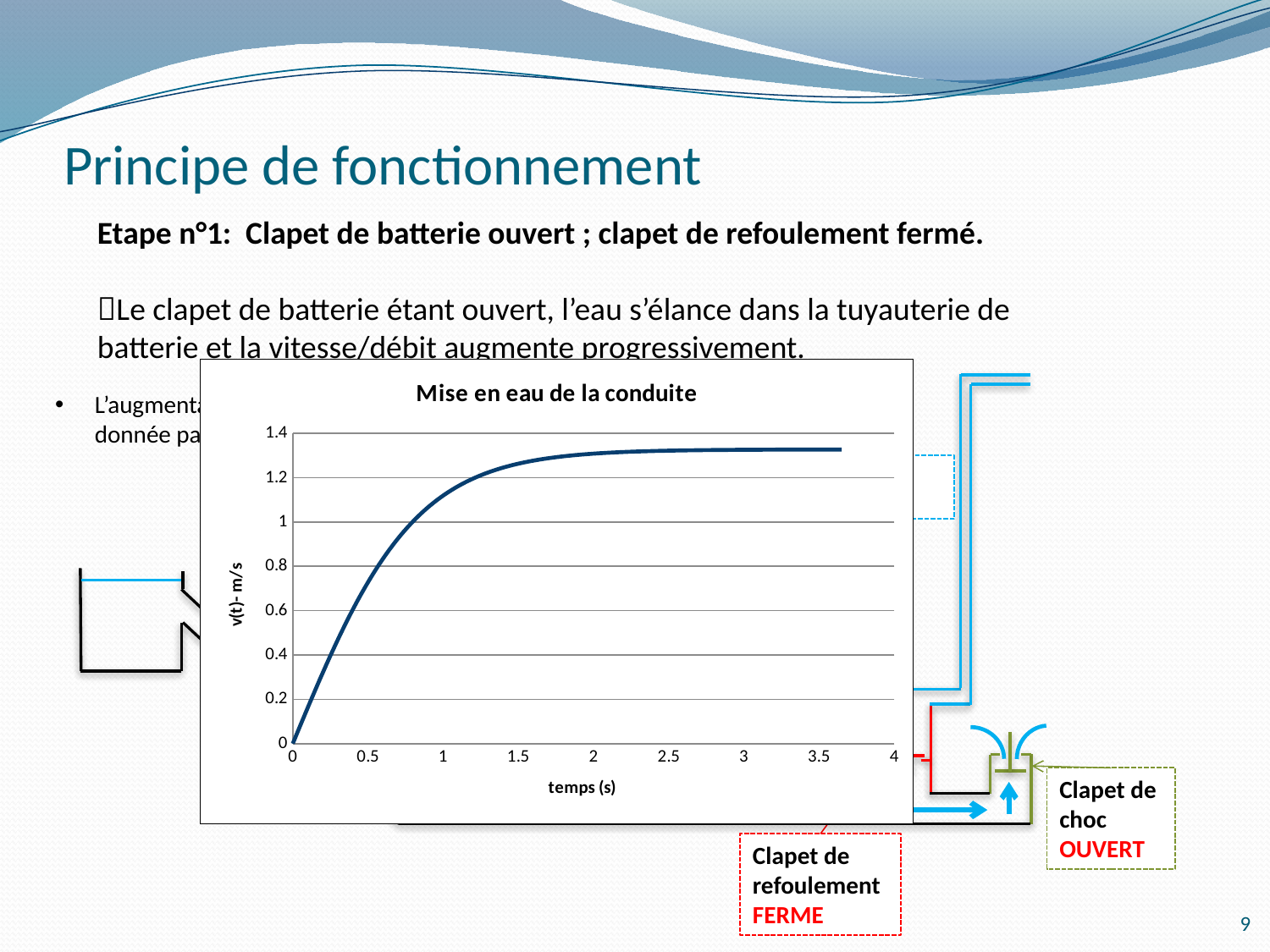
Is the value of v(t) at temps = 3.5 s greater or less than 1.4? less What is the label of the vertical axis of the chart? v(t)- m/s Is the value of v(t) at temps = 1 s greater or less than 1? greater Which is larger, the value of v(t) at temps = 0.5 s or at temps = 2 s? temps = 2 s Is the value of v(t) at temps = 3 s greater or less than 1.2? greater Does the plotted velocity v(t) rise or fall as temps (s) increases? rise What is the value of v(t) at temps = 0 s? 0 What kind of chart is shown under the title "Mise en eau de la conduite"? line chart What is the title of the chart on the slide? Mise en eau de la conduite